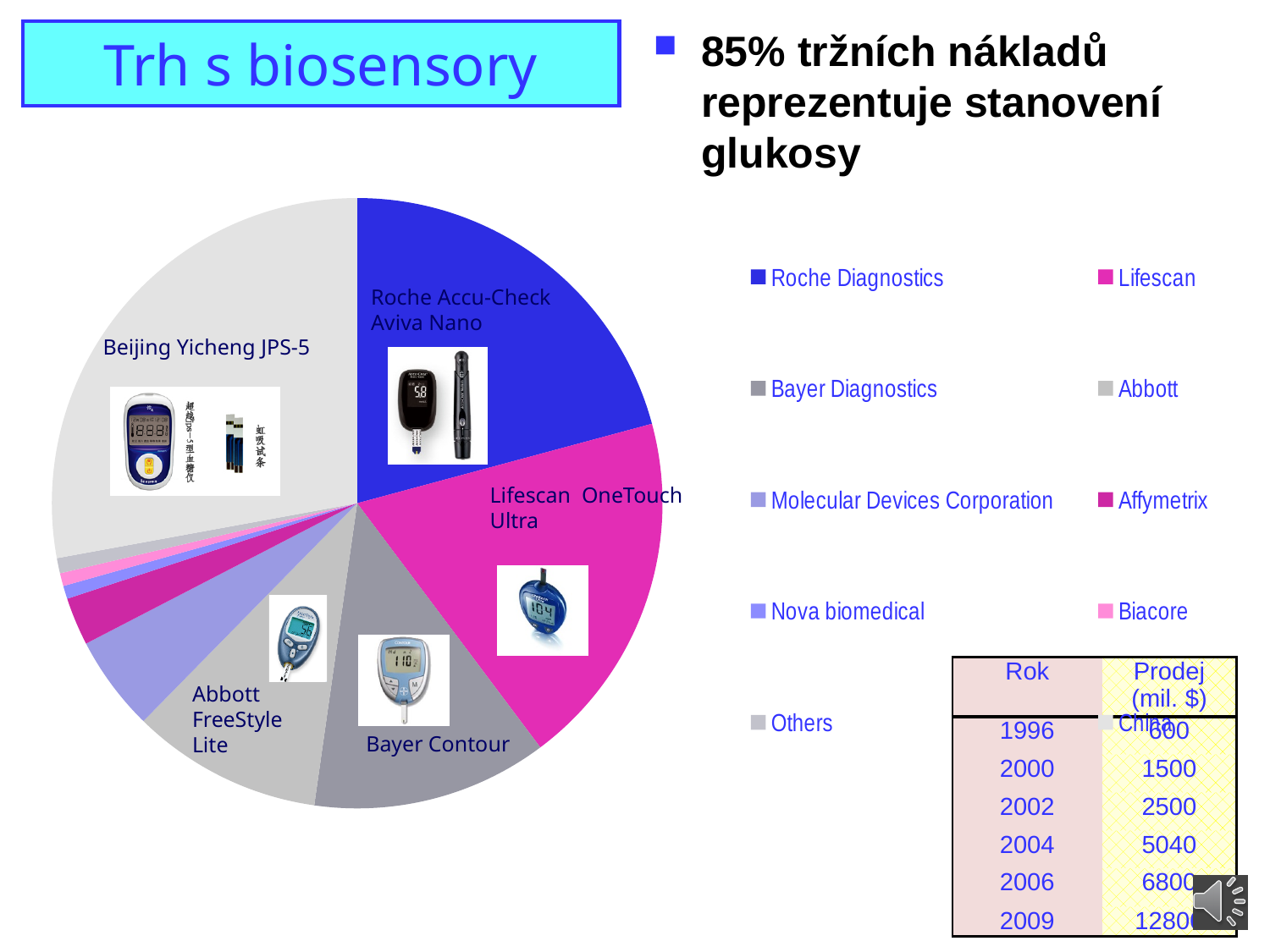
What colour is the Lifescan slice in the pie chart? magenta What is the title shown in the box at the top left of the slide? Trh s biosensory What kind of chart is shown on the slide? pie chart How many entries does the legend of the pie chart list? 10 Which is larger in the pie chart, the slice for Abbott or the slice for Biacore? Abbott Which is larger in the pie chart, the slice for Lifescan or the slice for Abbott? Lifescan Which product is labelled inside the Lifescan slice of the pie chart? Lifescan OneTouch Ultra Which is larger in the pie chart, the slice for Roche Diagnostics or the slice for Bayer Diagnostics? Roche Diagnostics Which product is labelled inside the Roche Diagnostics slice of the pie chart? Roche Accu-Check Aviva Nano